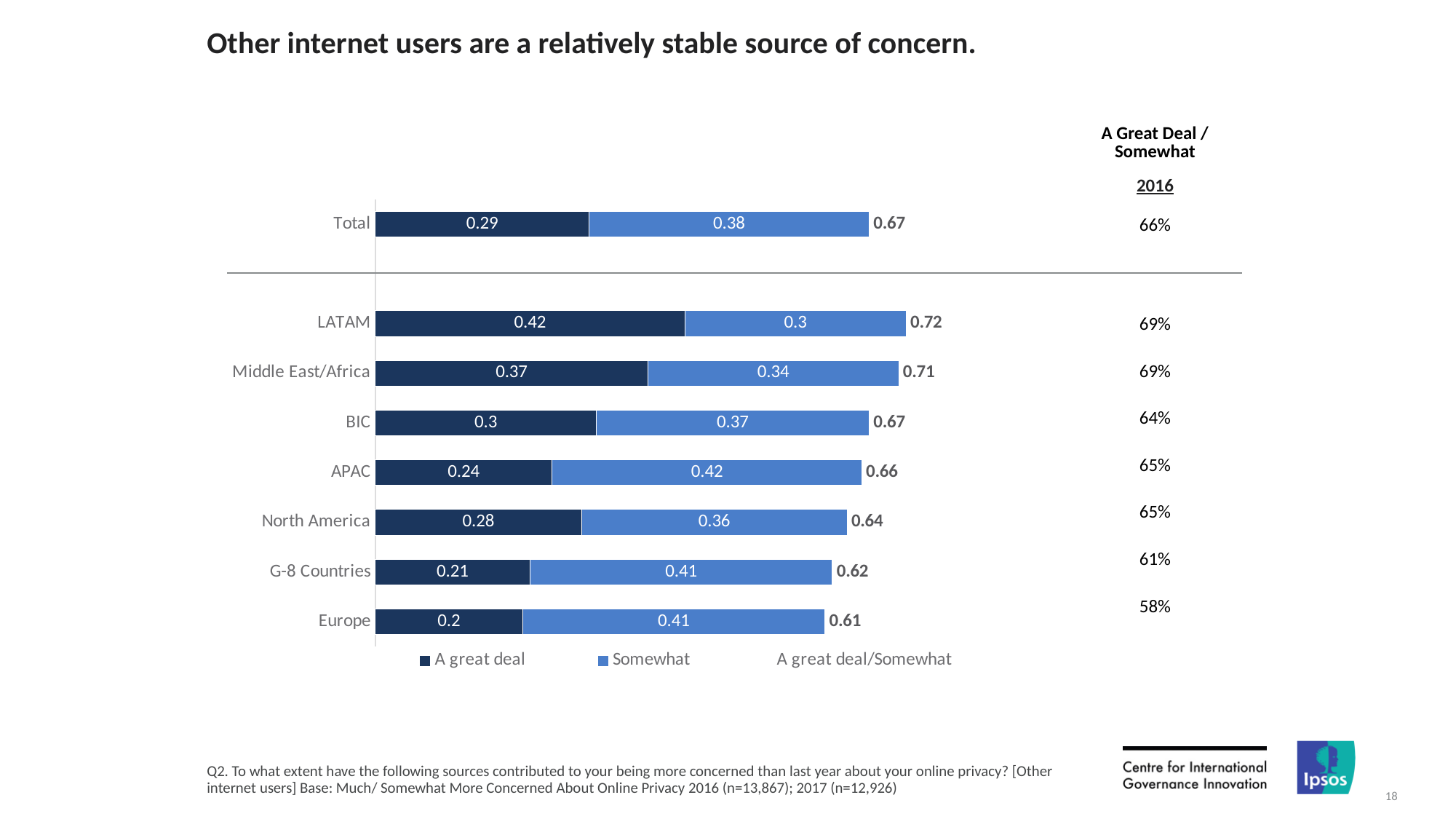
How many regions are plotted below the Total bar? 7 Which region has the lowest "A great deal" value? Europe What is the difference between the "A great deal" values for LATAM and Europe? 0.22 Which is larger, the "Somewhat" value for G-8 Countries or for North America? G-8 Countries What kind of chart is shown on the slide? Stacked bar chart What is the 2016 "A Great Deal / Somewhat" percentage shown for Europe? 58% What is the "A great deal" value for LATAM? 0.42 How many entries does the legend list? 3 What is the total of the stacked bar for North America? 0.64 What is the combined "A great deal/Somewhat" value shown for Middle East/Africa? 0.71 What is the "Somewhat" value for APAC? 0.42 Which region has the highest combined "A great deal/Somewhat" value? LATAM